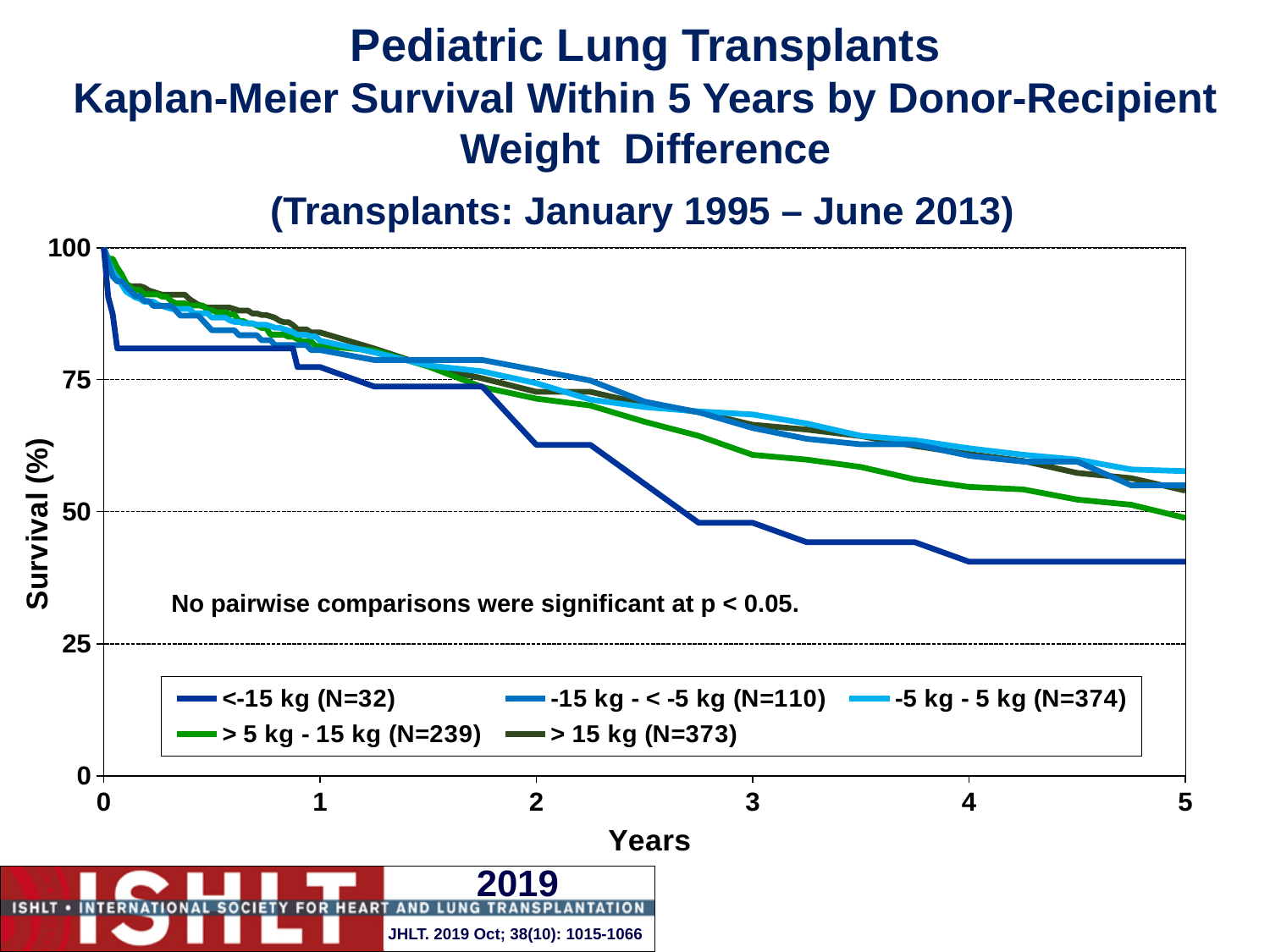
How many series does the legend list? 5 Is the survival for the <-15 kg group at 2 years greater or less than 75? less What does the annotation on the chart say about pairwise comparisons? No pairwise comparisons were significant at p < 0.05. At 3 years, which has higher survival: the > 5 kg - 15 kg group or the -5 kg - 5 kg group? -5 kg - 5 kg Is the survival for the -5 kg - 5 kg group at 5 years greater or less than 50? greater At 5 years, which has higher survival: the <-15 kg group or the -5 kg - 5 kg group? -5 kg - 5 kg What kind of chart is shown on the slide? Line chart Which weight-difference group has the lowest survival at 5 years? <-15 kg (N=32) Is the survival for the > 15 kg group at 5 years greater or less than 50? greater Do the survival curves rise or fall as years increase? Fall According to the legend, how many patients are in the <-15 kg group? N=32